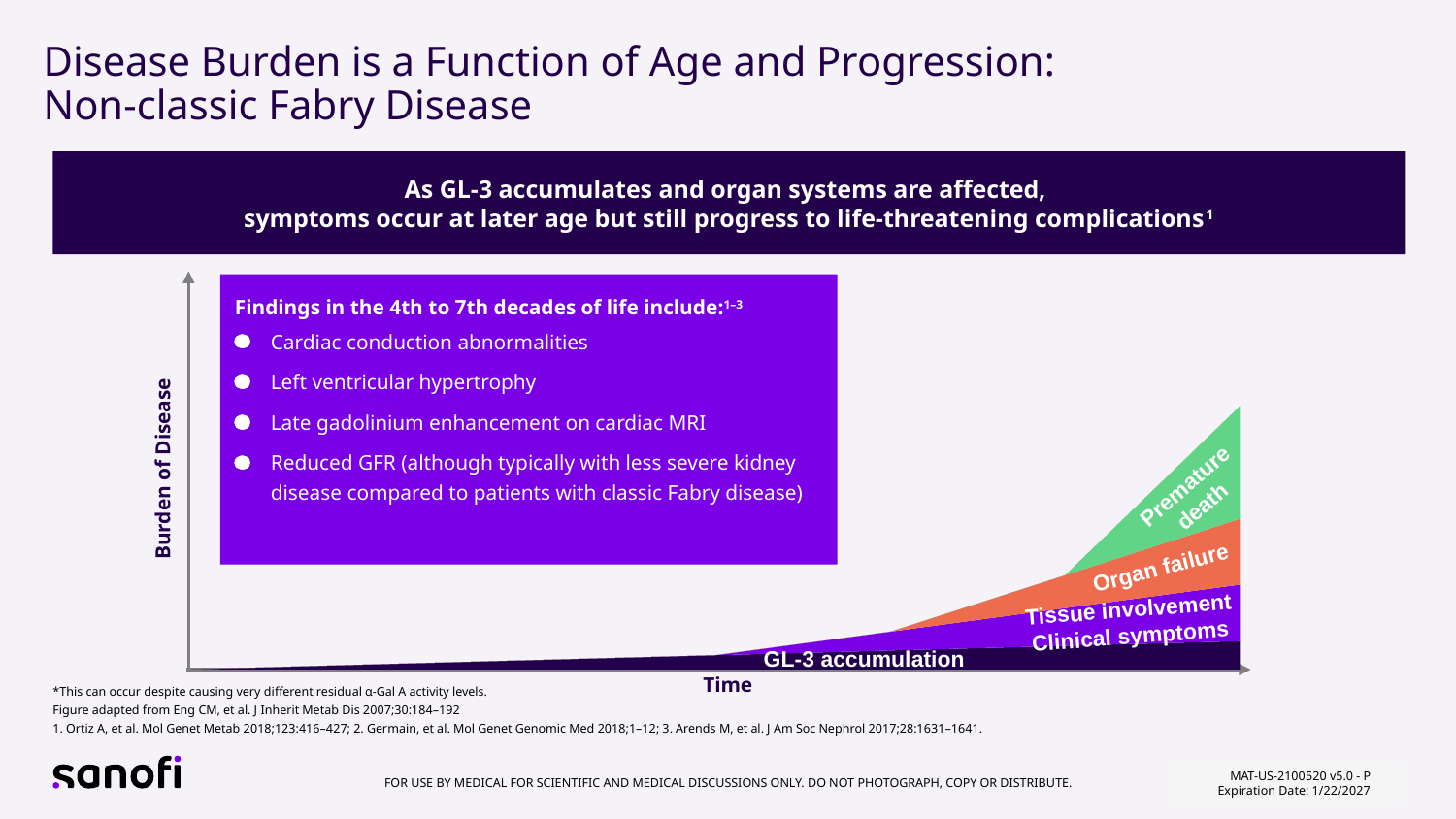
Which layer sits directly above 'Tissue involvement' in the chart? Organ failure Does the burden of disease rise or fall as time increases along the x axis? Rises Which layer sits directly above 'GL-3 accumulation' in the chart? Clinical symptoms Which layer sits directly below 'Premature death' in the chart? Organ failure What kind of chart is shown on the slide? Area chart Which layer is at the top of the chart? Premature death What is the label on the horizontal axis of the chart? Time What is the label on the vertical axis of the chart? Burden of Disease Which layer is at the bottom of the chart? GL-3 accumulation